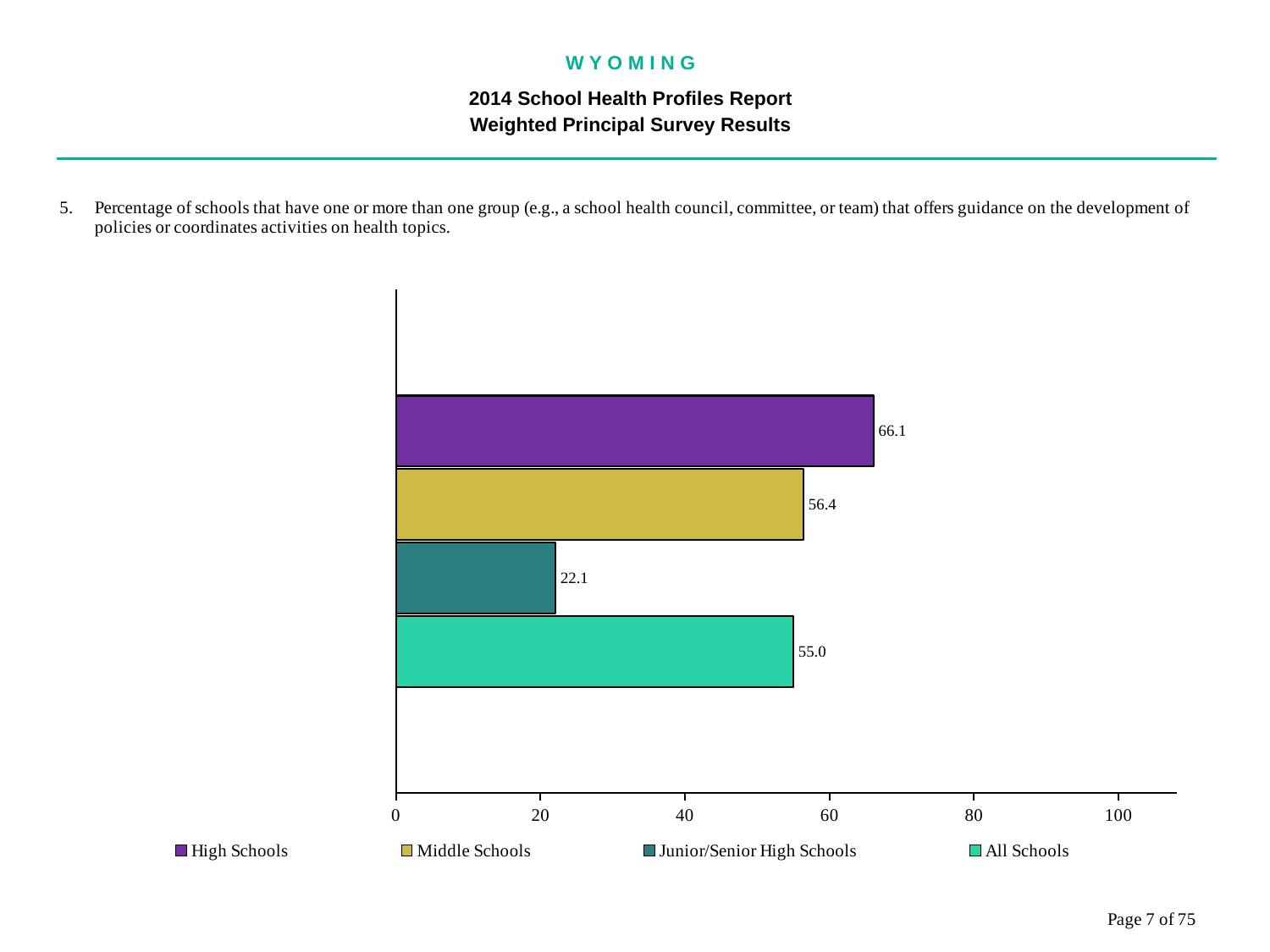
What is the value for High Schools? 66.1 What kind of chart is shown on the slide? bar chart What is the value for Middle Schools? 56.4 Which school category has the highest value? High Schools How many series does the legend list? 4 What is the value for Junior/Senior High Schools? 22.1 Is the value for Junior/Senior High Schools greater or less than 40? less What is the difference between the values for High Schools and Middle Schools? 9.7 What is the value for All Schools? 55.0 Which is larger, the value for High Schools or the value for All Schools? High Schools Which school category has the lowest value? Junior/Senior High Schools What is the difference between the values for Middle Schools and Junior/Senior High Schools? 34.3